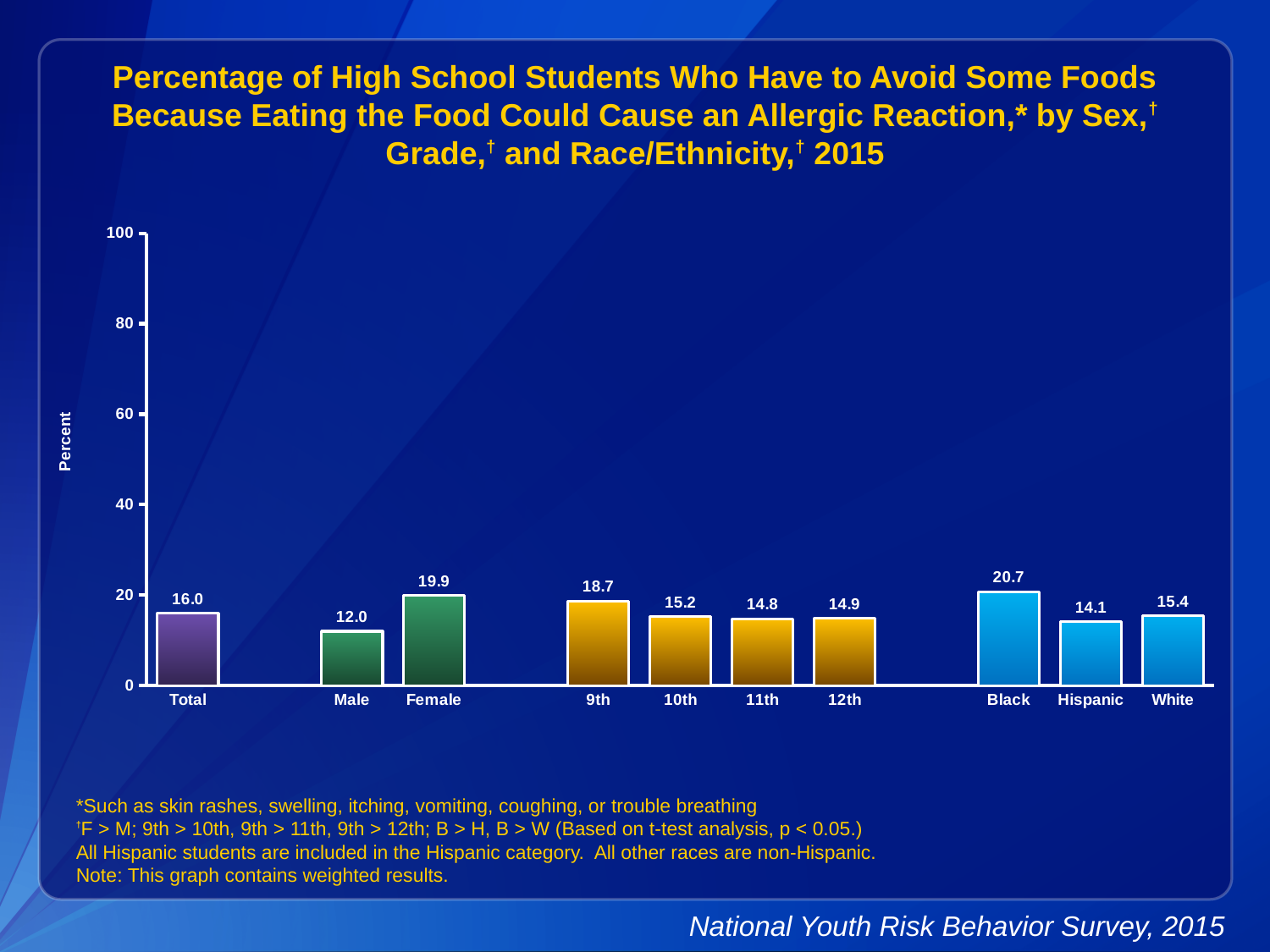
What is the value for Total? 16.0 Which is larger, the value for 9th grade or the value for 12th grade? 9th What is the difference between the Female and Male values? 7.9 What is the label of the y axis? Percent What is the value for Female? 19.9 What is the difference between the Black and White values? 5.3 Which category has the lowest value? Male What is the value for 9th grade? 18.7 Which category has the highest value? Black What is the value for Hispanic? 14.1 What kind of chart is shown on the slide? bar chart How many bars are shown in the chart? 10